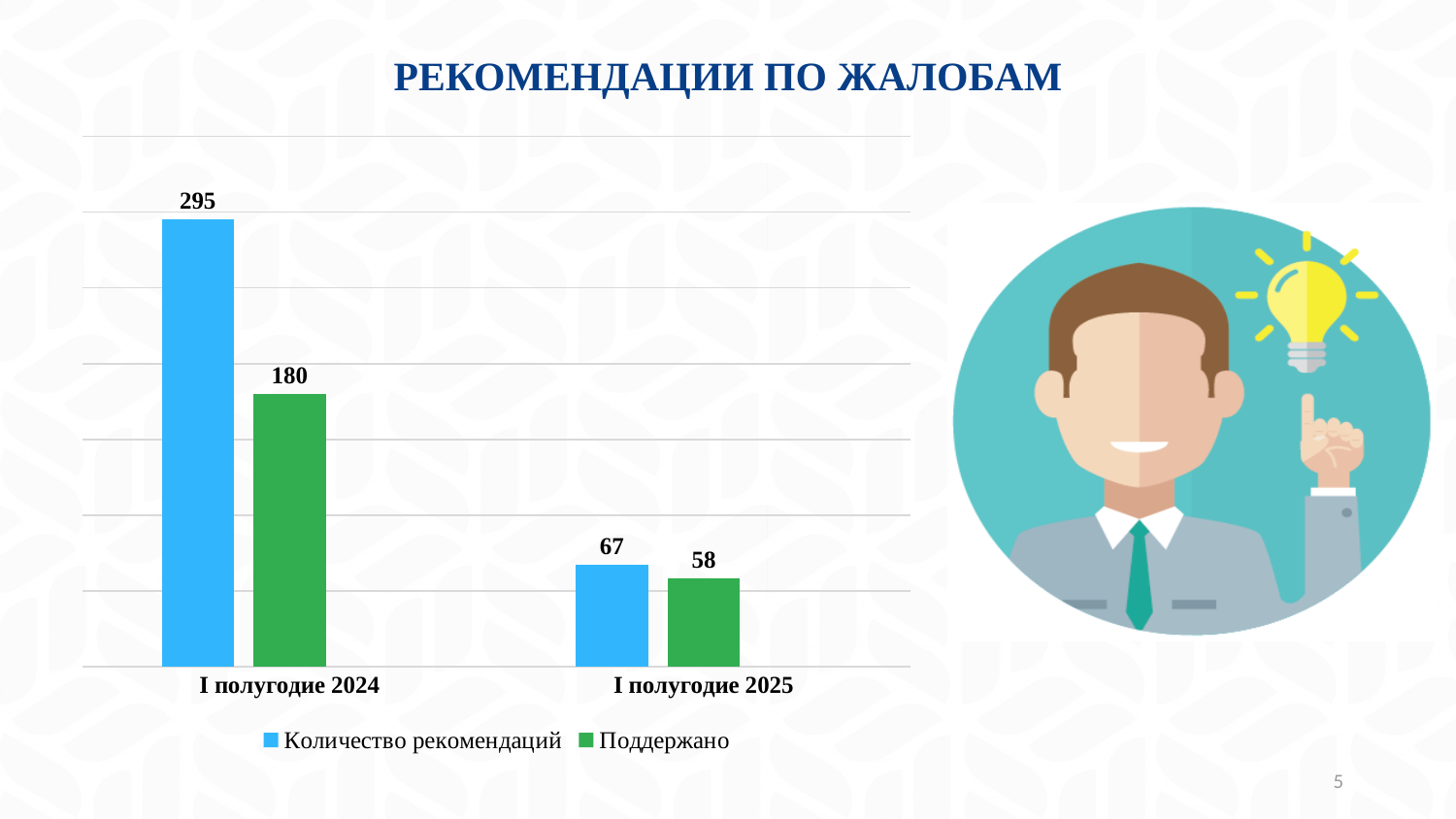
What is the difference between Количество рекомендаций and Поддержано for I полугодие 2025? 9 What is the value of Поддержано for I полугодие 2024? 180 Which category has the lowest value for Поддержано? I полугодие 2025 What kind of chart is shown on the slide? Bar chart What is the value of Количество рекомендаций for I полугодие 2025? 67 Which is larger: Поддержано for I полугодие 2024 or Количество рекомендаций for I полугодие 2025? Поддержано for I полугодие 2024 What is the value of Количество рекомендаций for I полугодие 2024? 295 What is the difference between Количество рекомендаций and Поддержано for I полугодие 2024? 115 How many series does the legend list? 2 Which category has the highest value for Количество рекомендаций? I полугодие 2024 What is the value of Поддержано for I полугодие 2025? 58 How many categories are shown on the x axis? 2